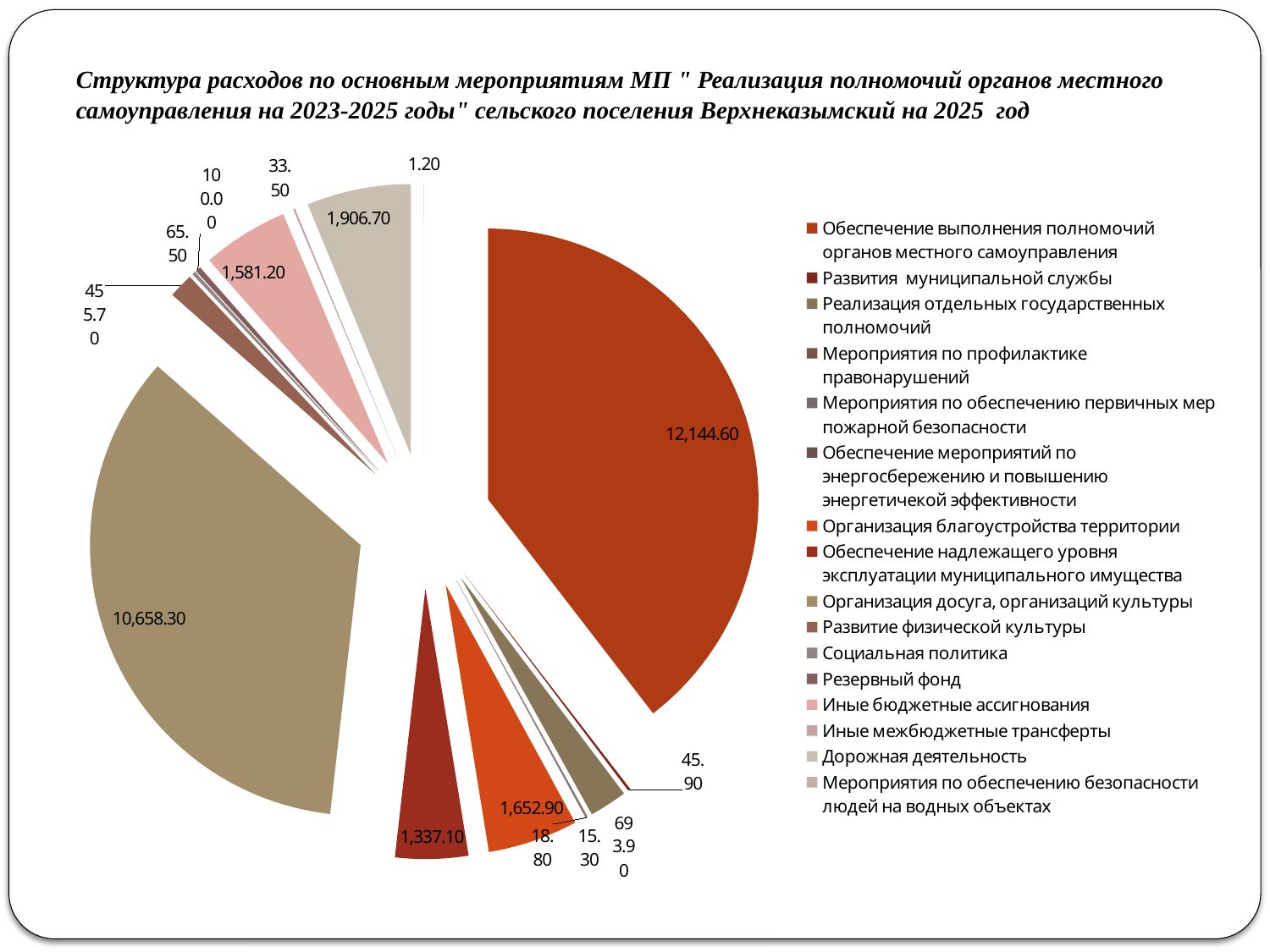
What is the value for Дорожная деятельность? 1,906.70 What is the smallest data label shown on the pie? 1.20 What is the value of the largest slice? 12,144.60 What is the difference between the two largest slices, 12,144.60 and 10,658.30? 1,486.30 What is the value for Обеспечение надлежащего уровня эксплуатации муниципального имущества? 1,337.10 Which category has the largest slice of the pie? Обеспечение выполнения полномочий органов местного самоуправления What type of chart is shown on the slide? Pie chart What is the value for Иные бюджетные ассигнования? 1,581.20 Which is larger: Дорожная деятельность or Иные бюджетные ассигнования? Дорожная деятельность What is the value for Организация досуга, организаций культуры? 10,658.30 How many categories does the legend list? 16 What is the value for Организация благоустройства территории? 1,652.90